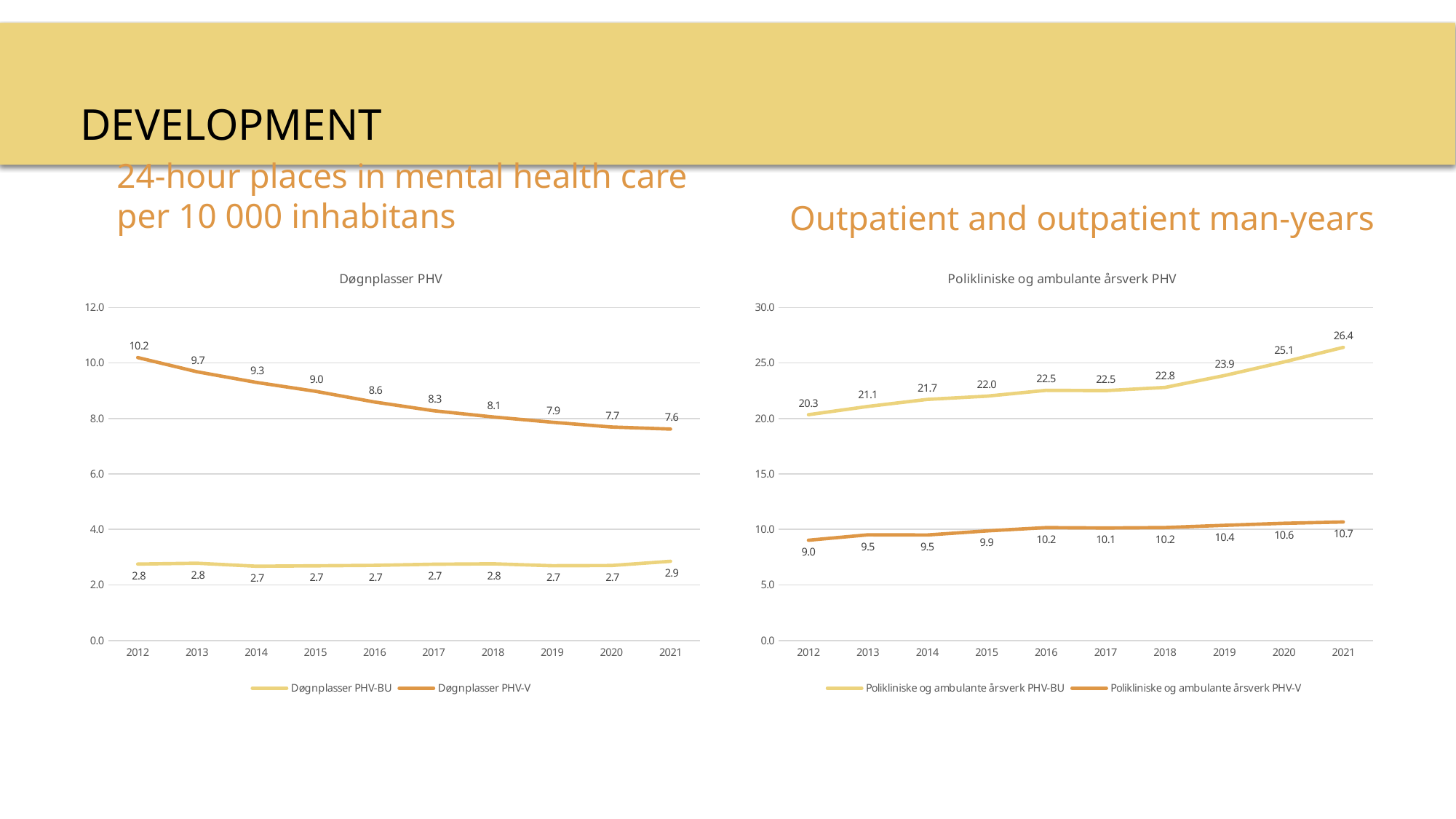
In the 'Døgnplasser PHV' chart, what is the value for Døgnplasser PHV-BU in 2021? 2.9 In the 'Poliklinske og ambulante årsverk PHV' chart, in which year is Poliklinske og ambulante årsverk PHV-BU highest? 2021 In the 'Poliklinske og ambulante årsverk PHV' chart, what is the value for Poliklinske og ambulante årsverk PHV-BU in 2021? 26.4 In the 'Poliklinske og ambulante årsverk PHV' chart, what is the difference between Poliklinske og ambulante årsverk PHV-BU and PHV-V in 2021? 15.7 In the 'Poliklinske og ambulante årsverk PHV' chart, how many series does the legend list? 2 In the 'Døgnplasser PHV' chart, does Døgnplasser PHV-V rise or fall from 2012 to 2021? fall In the 'Døgnplasser PHV' chart, what is the difference between Døgnplasser PHV-V in 2012 and in 2021? 2.6 In the 'Døgnplasser PHV' chart, what type of chart is shown? line chart In the 'Poliklinske og ambulante årsverk PHV' chart, how many years are shown on the x axis? 10 In the 'Døgnplasser PHV' chart, in which year is Døgnplasser PHV-V lowest? 2021 In the 'Døgnplasser PHV' chart, what is the value for Døgnplasser PHV-V in 2012? 10.2 In the 'Poliklinske og ambulante årsverk PHV' chart, what is the value for Poliklinske og ambulante årsverk PHV-V in 2016? 10.2